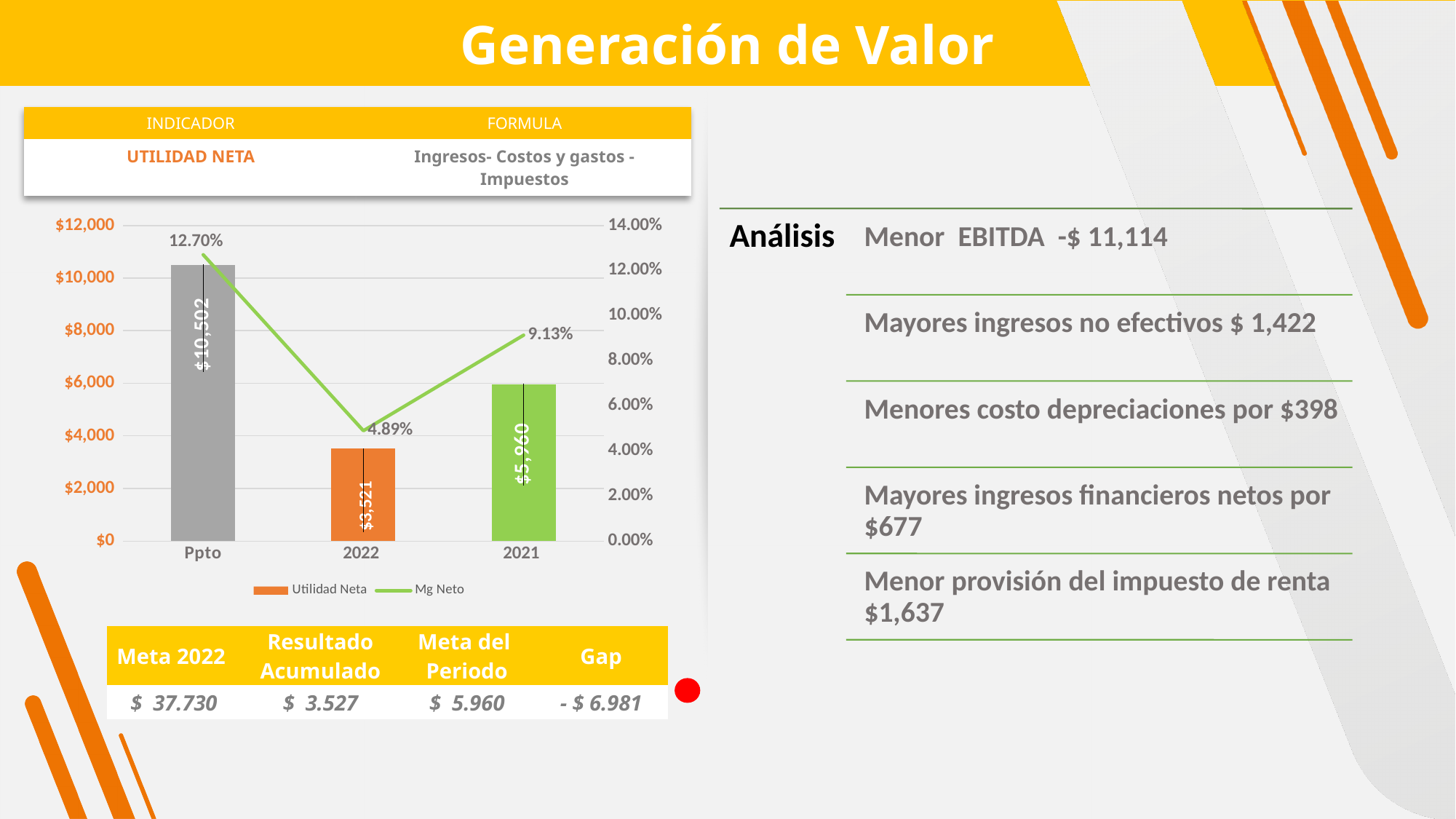
How many series does the chart legend list? 2 Which category has the lowest Mg Neto? 2022 What is the Mg Neto value for Ppto? 12.70% How many categories are shown on the x axis of the chart? 3 What is the Utilidad Neta value for 2021? $5,960 Which series is drawn as a line in the chart? Mg Neto What is the Utilidad Neta value for 2022? $3,521 What is the Utilidad Neta value for Ppto? $10,502 Which has a higher Mg Neto, 2021 or 2022? 2021 Which category has the highest Utilidad Neta? Ppto What is the Mg Neto value for 2022? 4.89% What is the difference in Utilidad Neta between 2021 and 2022? $2,439